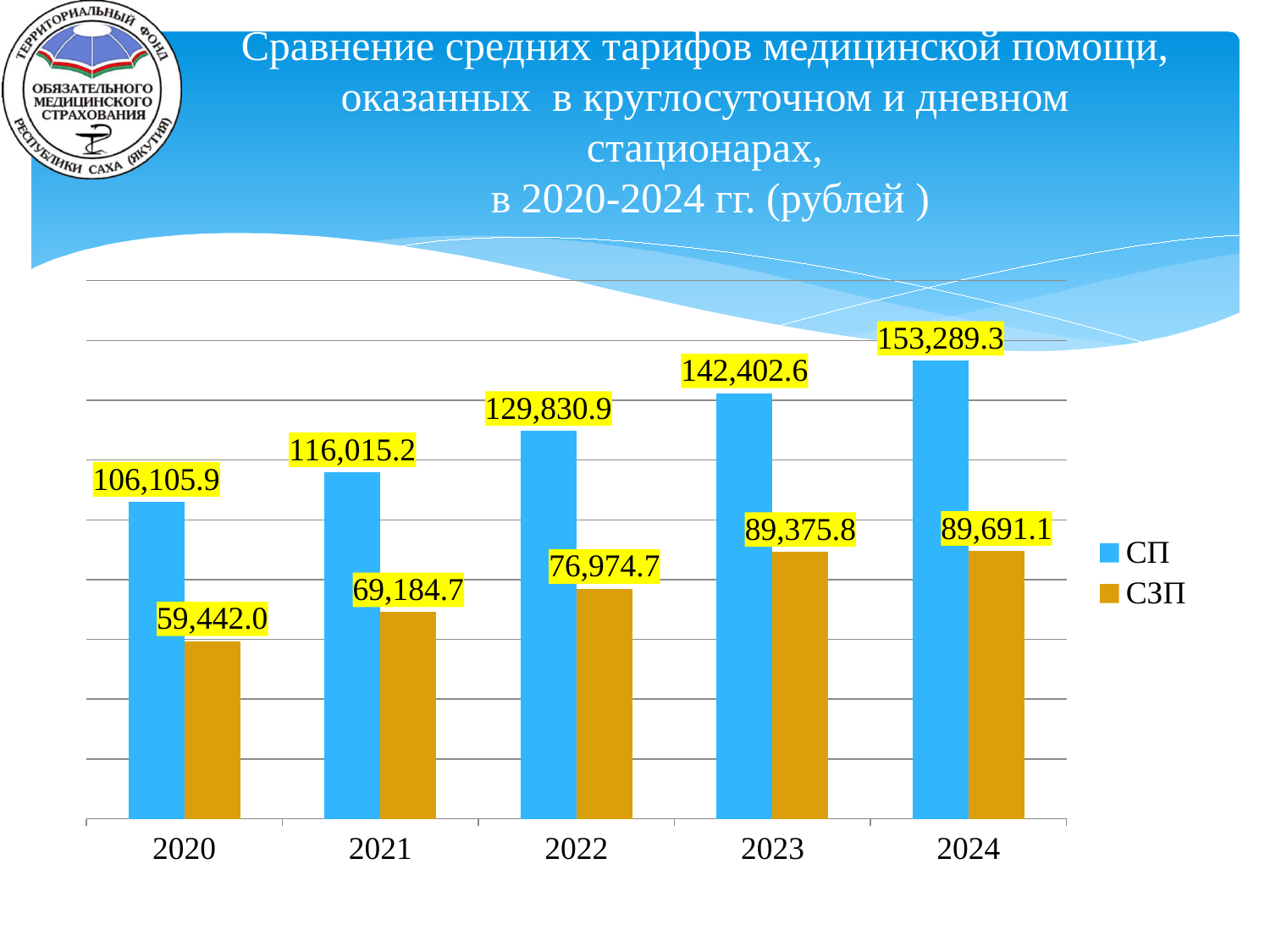
In which year is the СП value highest? 2024 What is the value for СЗП in 2020? 59,442.0 What is the value for СП in 2021? 116,015.2 How many years are shown on the x axis? 5 Which is larger in 2023, the СП value or the СЗП value? СП What kind of chart is shown on the slide? Bar chart What is the difference between the СП and СЗП values in 2024? 63,598.2 What is the value for СП in 2024? 153,289.3 How many series does the legend list? 2 By how much did the СП value increase from 2020 to 2024? 47,183.4 In which year is the СЗП value lowest? 2020 What is the value for СЗП in 2022? 76,974.7